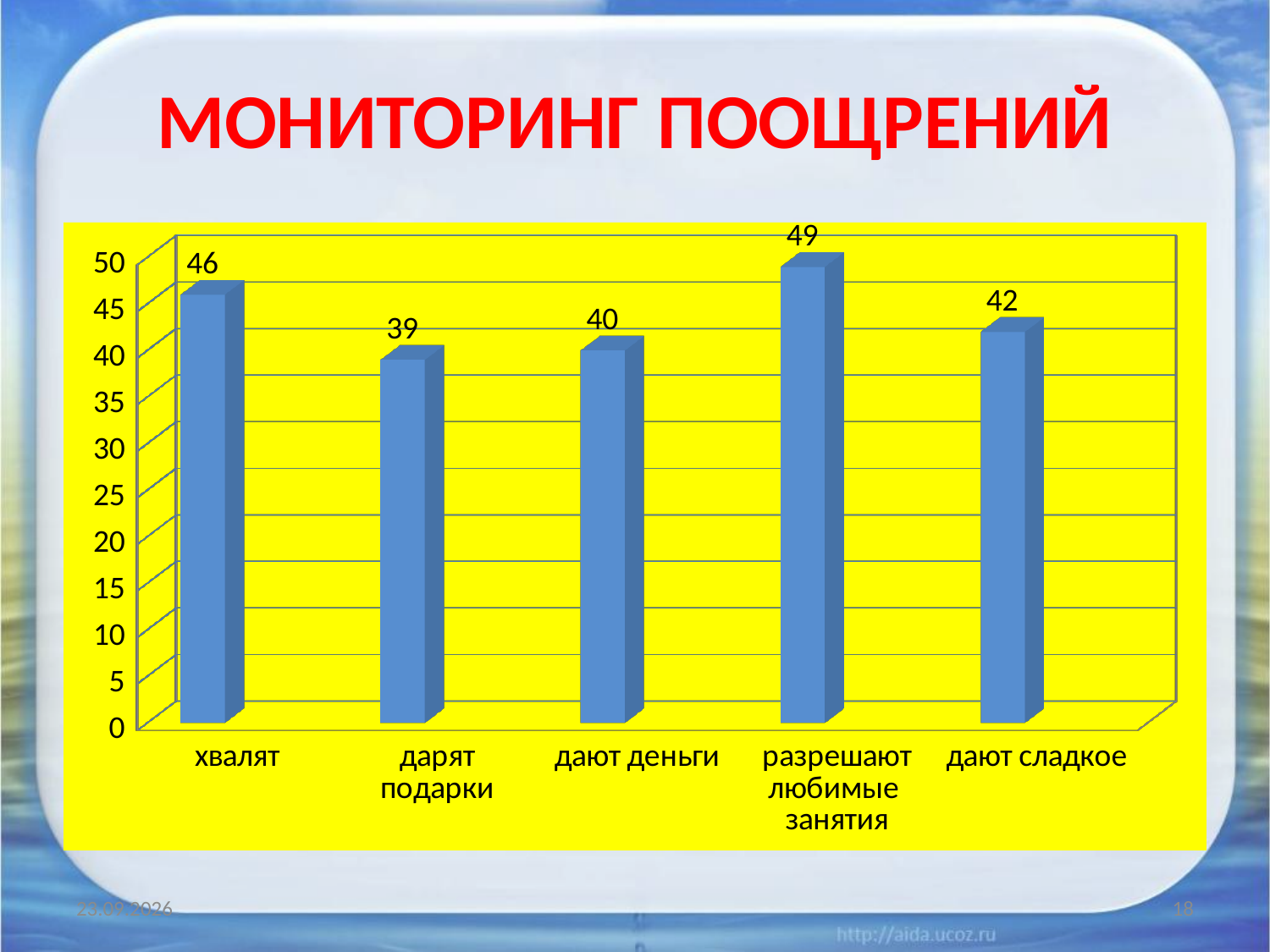
Which category has the highest value? разрешают любимые занятия Is the value for "дают деньги" greater or less than 45? less What kind of chart is shown on the slide? bar chart Which category has the lowest value? дарят подарки How many categories are shown on the chart? 5 What is the value for "дают сладкое"? 42 What is the value for "разрешают любимые занятия"? 49 What is the difference between the values for "разрешают любимые занятия" and "дарят подарки"? 10 What is the title of the slide? МОНИТОРИНГ ПООЩРЕНИЙ What is the value for "дарят подарки"? 39 Which is larger, the value for "хвалят" or the value for "дают сладкое"? хвалят What is the value for "хвалят"? 46